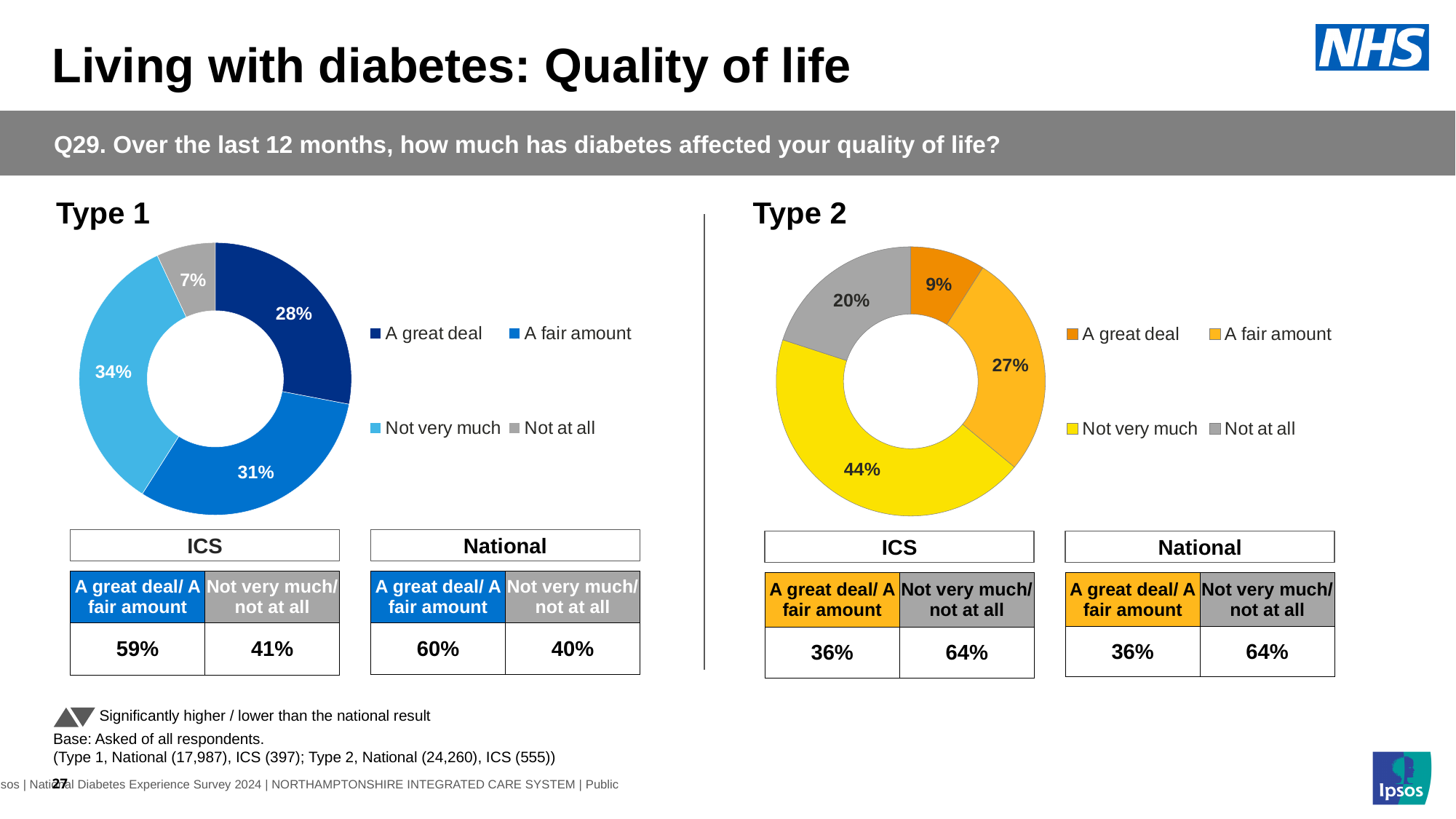
How many response categories does the legend of the Type 2 chart list? 4 In the Type 1 chart, what is the difference between the 'Not very much' and 'A great deal' shares? 6 percentage points In the Type 1 chart, what percentage of respondents said diabetes affected their quality of life 'A great deal'? 28% What kind of chart is used to show the Type 1 results? Doughnut (pie) chart In the Type 2 chart, which response category has the smallest share? A great deal In the Type 2 chart, what percentage of respondents said 'Not very much'? 44% In the Type 2 chart, what is the combined share of 'A great deal' and 'A fair amount'? 36% In the Type 1 chart, what percentage said 'Not at all'? 7% In the Type 2 chart, which is larger: 'Not at all' or 'A great deal'? Not at all In the Type 1 chart, what colour represents 'Not at all'? Grey In the Type 2 chart, what percentage said 'A fair amount'? 27% In the Type 1 chart, which response category has the largest share? Not very much